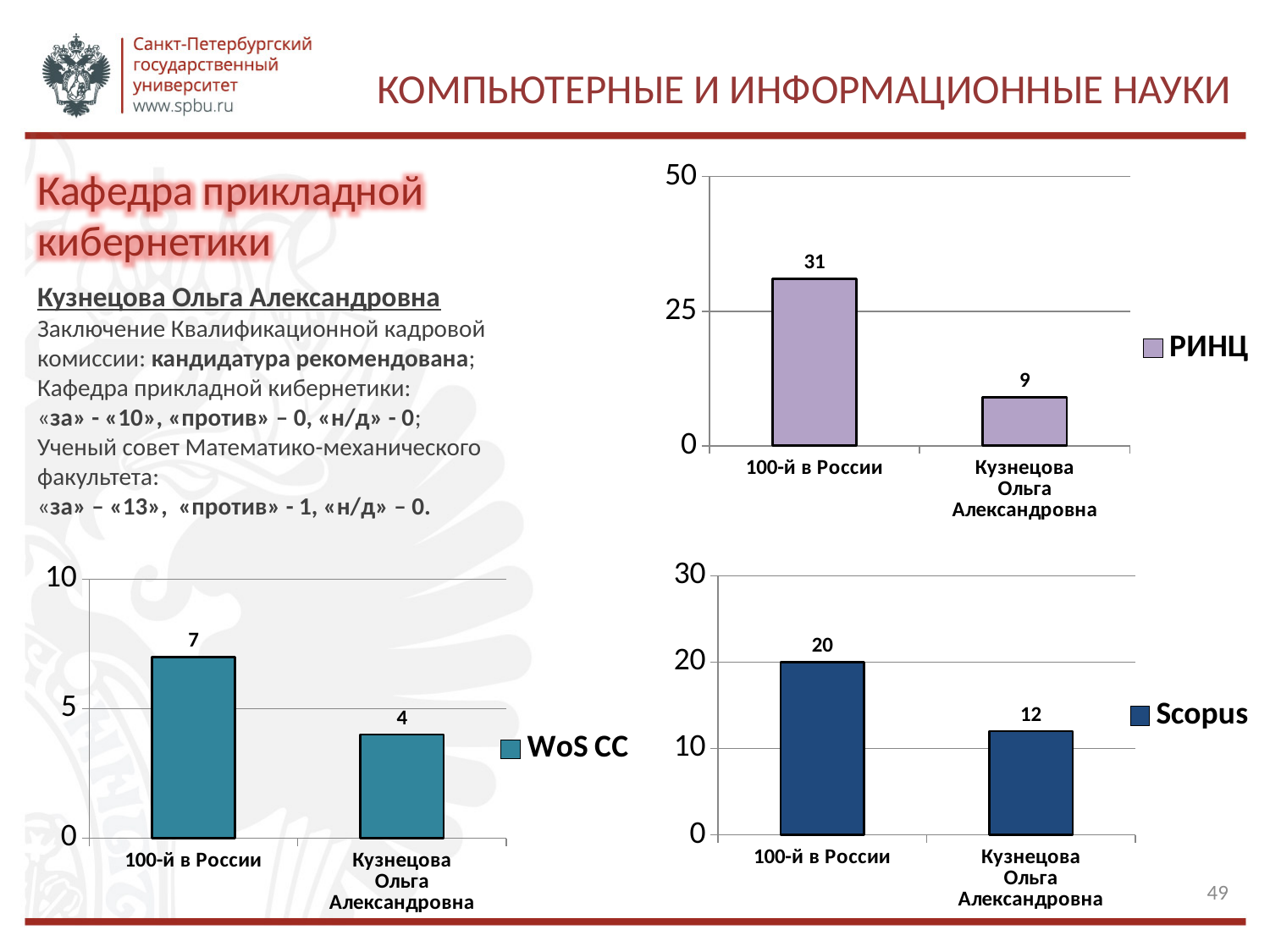
In the WoS CC chart (bottom left), which is larger: the value for 100-й в России or for Кузнецова Ольга Александровна? 100-й в России What kind of chart is the РИНЦ chart (top right)? Bar chart In the РИНЦ chart (top right), what is the value for 100-й в России? 31 How many categories are shown in the Scopus chart (bottom right)? 2 In the Scopus chart (bottom right), which category has the lowest value? Кузнецова Ольга Александровна In the WoS CC chart (bottom left), which category has the highest value? 100-й в России In the WoS CC chart (bottom left), what is the value for Кузнецова Ольга Александровна? 4 In the РИНЦ chart (top right), what is the difference between the values for 100-й в России and Кузнецова Ольга Александровна? 22 What series name does the legend of the bottom-left chart show? WoS CC In the Scopus chart (bottom right), what is the value for 100-й в России? 20 In the РИНЦ chart (top right), what is the value for Кузнецова Ольга Александровна? 9 In the Scopus chart (bottom right), what is the difference between the values for 100-й в России and Кузнецова Ольга Александровна? 8